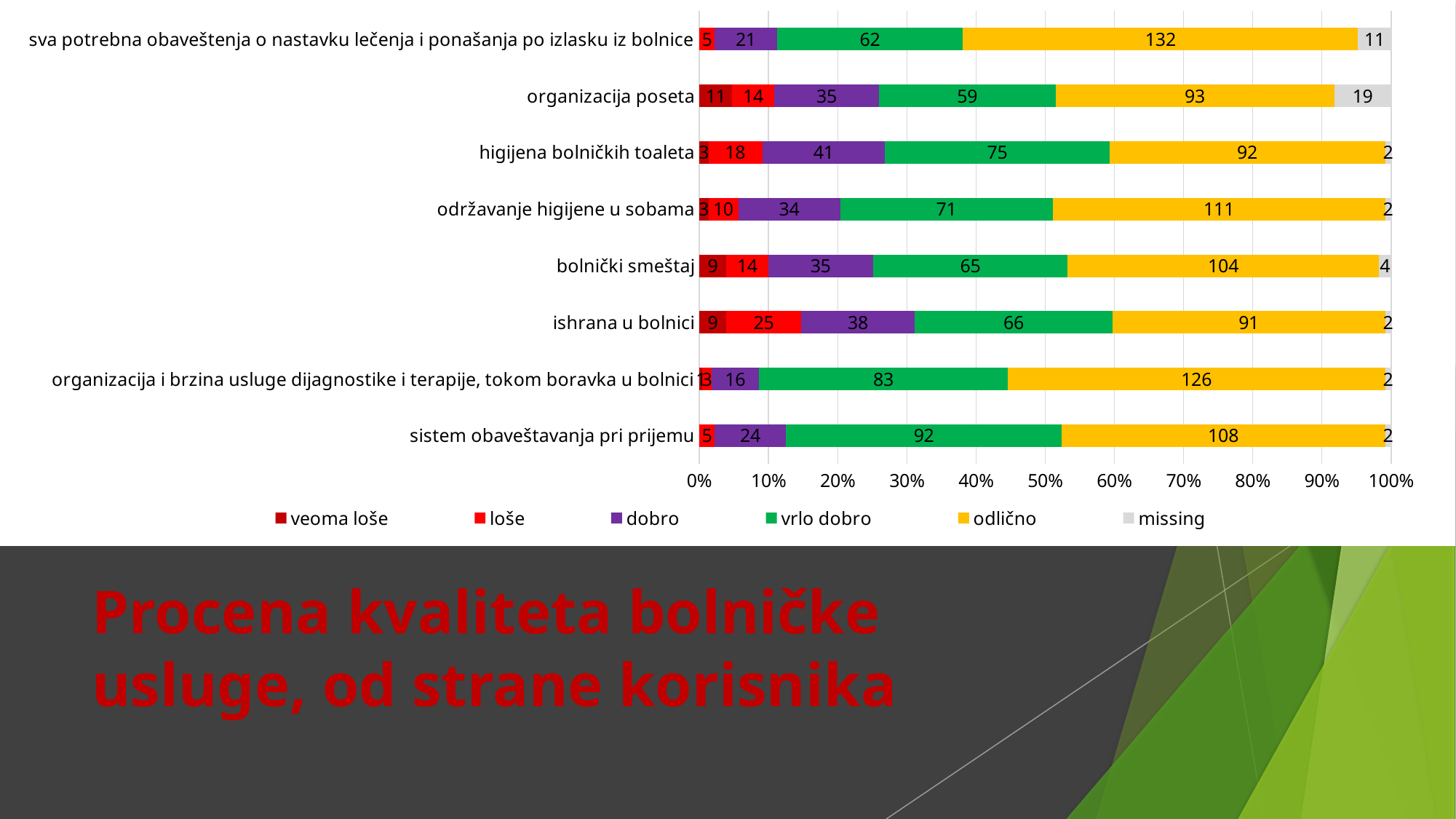
What is the 'dobro' value for 'higijena bolničkih toaleta'? 41 Which has a larger 'vrlo dobro' value: 'organizacija i brzina usluge dijagnostike i terapije, tokom boravka u bolnici' or 'ishrana u bolnici'? organizacija i brzina usluge dijagnostike i terapije, tokom boravka u bolnici What is the difference between the 'odlično' values for 'održavanje higijene u sobama' and 'bolnički smeštaj'? 7 What is the 'missing' value for 'organizacija poseta'? 19 How many series does the legend list? 6 Which category has the lowest 'odlično' value? ishrana u bolnici What kind of chart is shown on the slide? Stacked bar chart What is the 'odlično' value for 'organizacija poseta'? 93 How many categories are shown on the chart? 8 Which category has the highest 'odlično' value? sva potrebna obaveštenja o nastavku lečenja i ponašanja po izlasku iz bolnice What is the 'vrlo dobro' value for 'sistem obaveštavanja pri prijemu'? 92 What is the 'loše' value for 'ishrana u bolnici'? 25